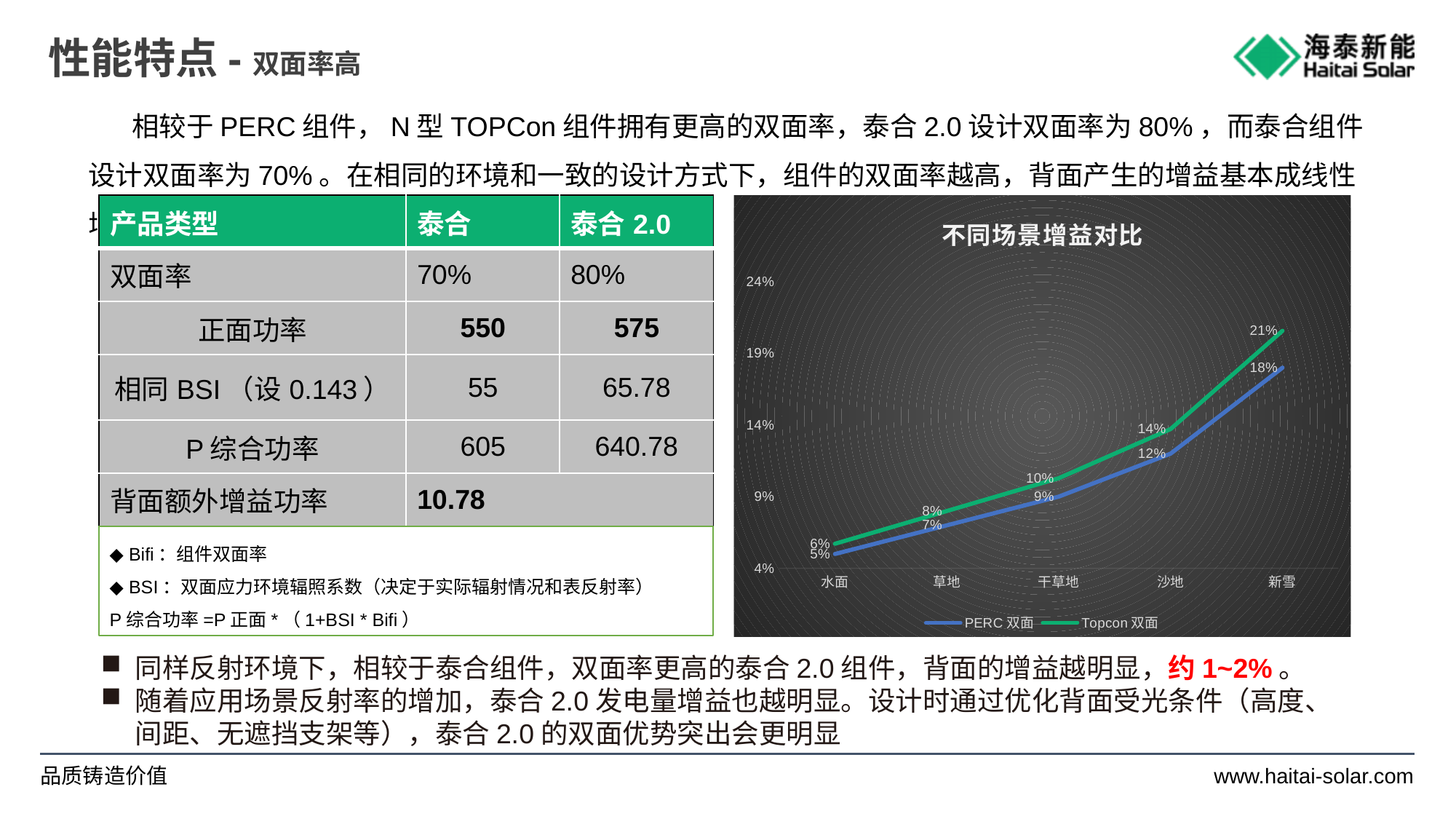
Which scenario has the lowest value for Topcon 双面? 水面 How many scenario categories are shown on the x axis of the chart? 5 How many series does the chart legend list? 2 Which scenario has the highest value for PERC 双面? 新雪 What is the difference between Topcon 双面 and PERC 双面 at 新雪? 3% What is the value for PERC 双面 at 沙地? 12% What is the value for Topcon 双面 at 新雪? 21% What type of chart is shown on the slide? Line chart Do the values for Topcon 双面 rise or fall from 水面 to 新雪? Rise What is the value for Topcon 双面 at 水面? 6% Which is larger at 干草地: PERC 双面 or Topcon 双面? Topcon 双面 What is the title of the chart? 不同场景增益对比